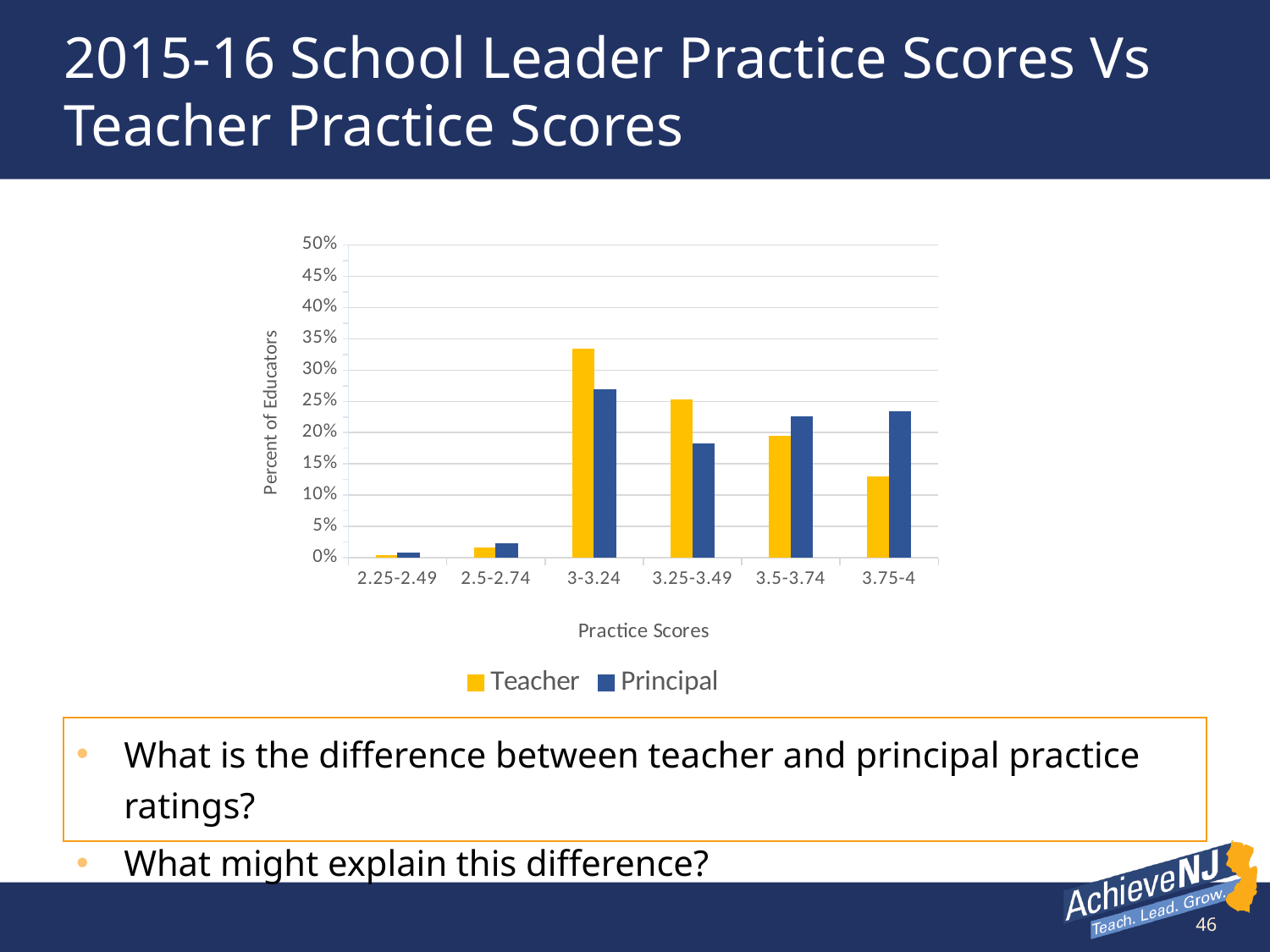
What kind of chart is shown on the slide? Bar chart Which practice score category has the highest value for Teacher? 3-3.24 Is the Principal value for 3.25-3.49 greater or less than 20%? less How many series does the legend list? 2 Is the Teacher value for 3-3.24 greater or less than 30%? greater In the 3.75-4 category, which is larger, Teacher or Principal? Principal What is the title of the vertical axis? Percent of Educators Which practice score category has the lowest value for Teacher? 2.25-2.49 Which practice score category has the highest value for Principal? 3-3.24 Do the Teacher values rise or fall from the 3-3.24 category to the 3.75-4 category? fall How many practice score categories are shown on the x axis? 6 In the 3.25-3.49 category, which is larger, Teacher or Principal? Teacher